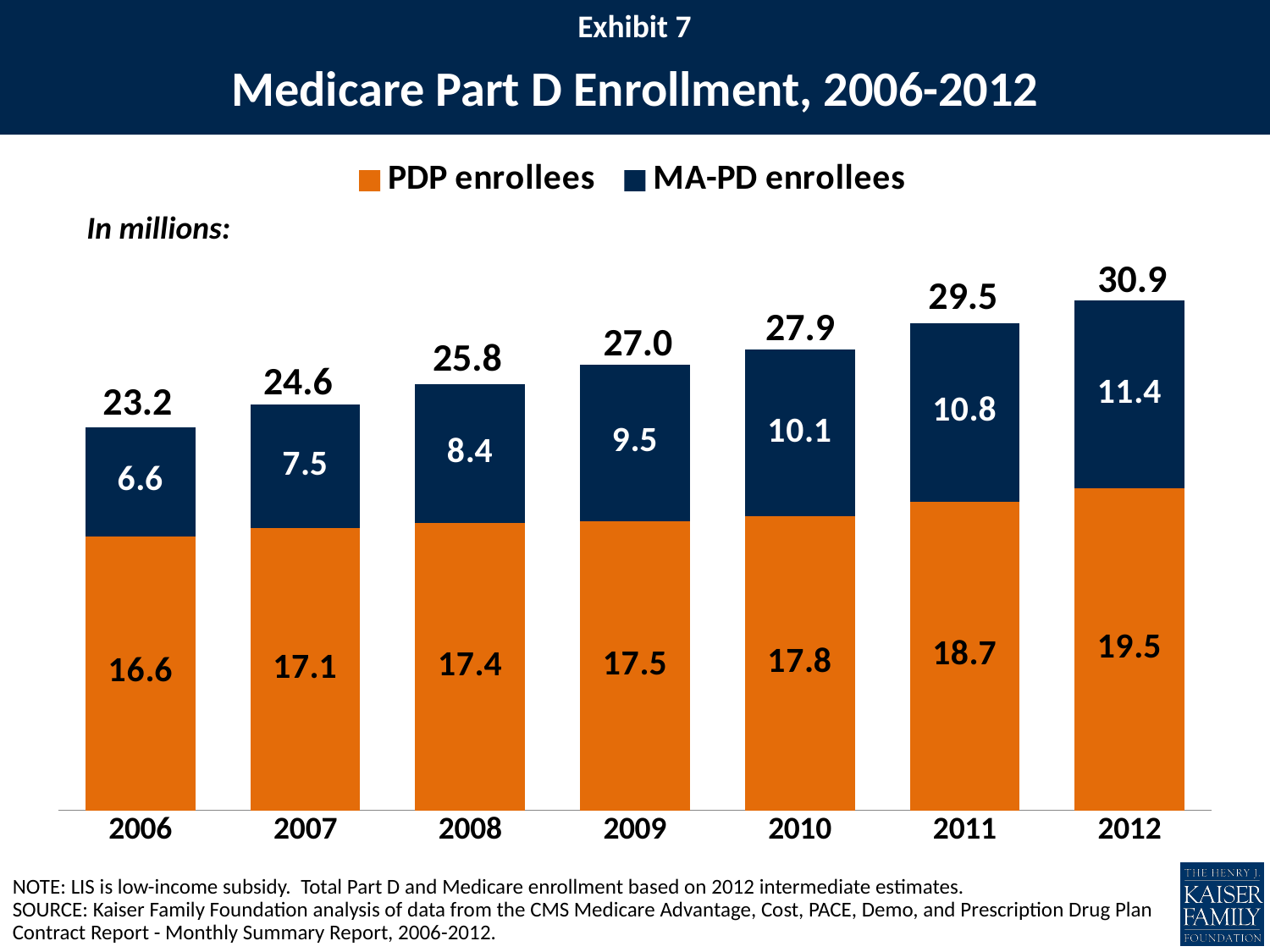
What kind of chart is shown on the slide? Stacked bar chart Which is larger in 2009: PDP enrollees or MA-PD enrollees? PDP enrollees What is the number of PDP enrollees in 2008? 17.4 Which year has the highest number of MA-PD enrollees? 2012 How many series does the legend list? 2 What is the difference between PDP enrollees in 2012 and 2006? 2.9 What is the total Part D enrollment shown for 2012? 30.9 How many years are shown on the x axis? 7 What is the number of MA-PD enrollees in 2010? 10.1 Which year has the lowest number of PDP enrollees? 2006 Do total Part D enrollment values rise or fall from 2006 to 2012? Rise What unit are the values on the chart expressed in? Millions